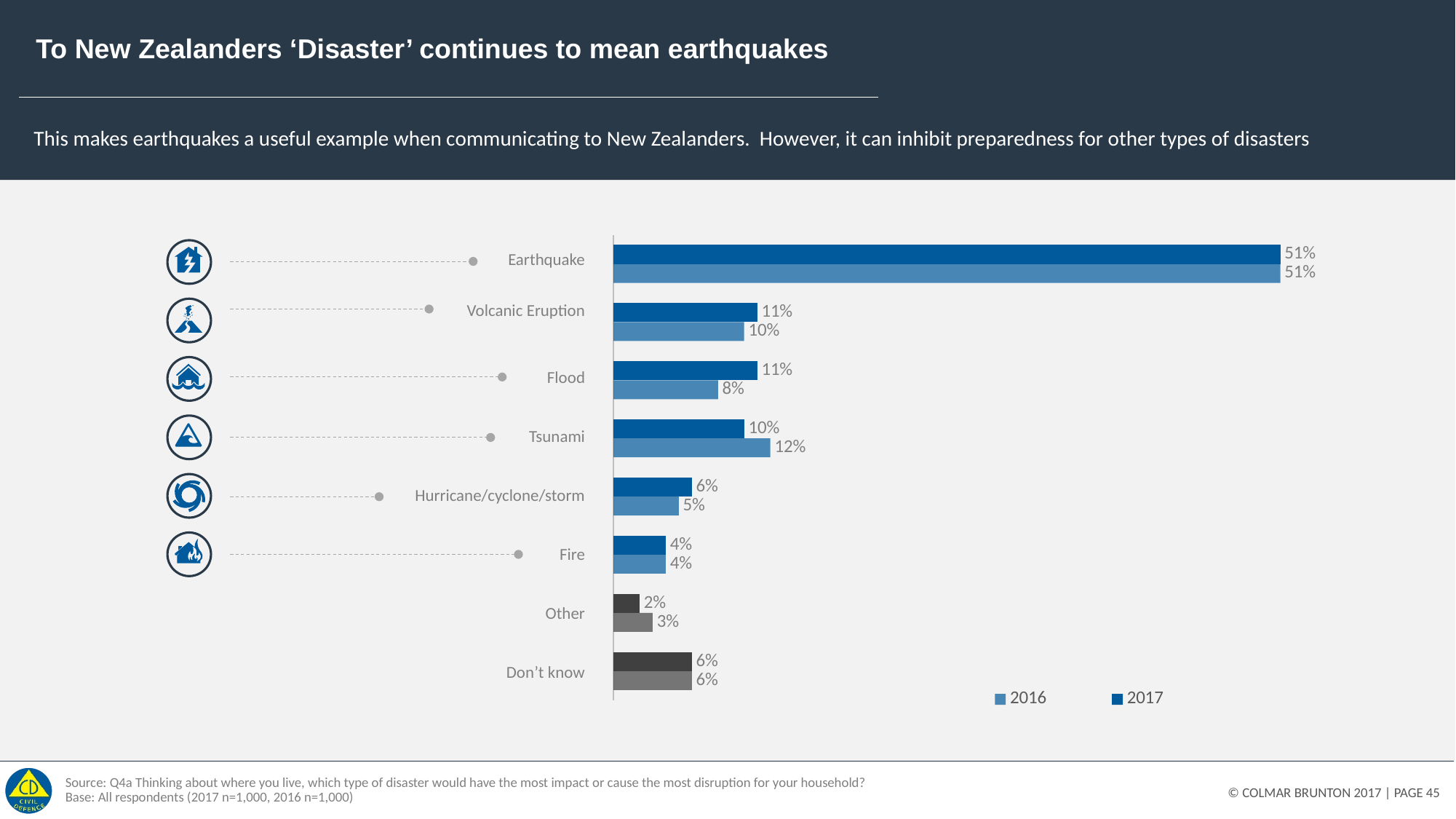
What is the difference between the 2017 and 2016 values for Flood? 3% What type of chart is shown on the slide? Bar chart Which category has the lowest value in 2017? Other How many categories are shown on the chart? 8 Which disaster type has the highest value in 2017? Earthquake How many series does the legend list? 2 What is the 2017 value for Hurricane/cyclone/storm? 6% For Tsunami, which year has the larger value, 2016 or 2017? 2016 Which series does the lighter blue colour represent in the legend? 2016 What is the 2016 value for Flood? 8% What percentage of respondents named Earthquake in 2017? 51% What is the 2016 value for Tsunami? 12%